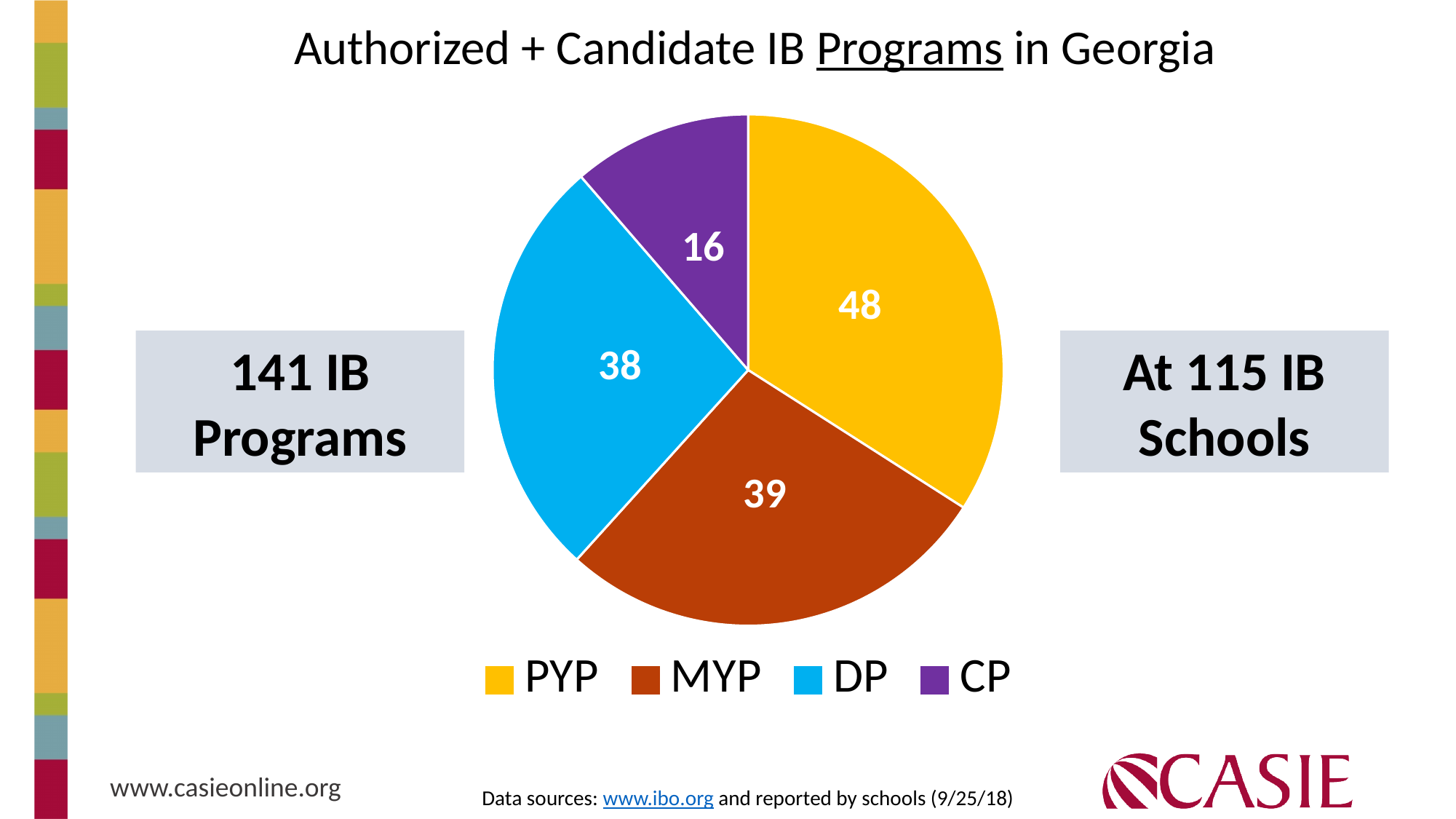
What is the value shown for MYP in the pie chart? 39 What is the value shown for CP in the pie chart? 16 What type of chart is shown on the slide? pie chart What is the difference between the MYP value and the DP value? 1 Which program type has the largest slice of the pie chart? PYP How many categories does the pie chart legend list? 4 What is the title of the slide containing the pie chart? Authorized + Candidate IB Programs in Georgia What is the difference between the PYP value and the CP value? 32 What is the value shown for DP in the pie chart? 38 Which program type has the smallest slice of the pie chart? CP Which is larger, the PYP slice or the MYP slice? PYP How many IB programs in Georgia are PYP according to the pie chart? 48